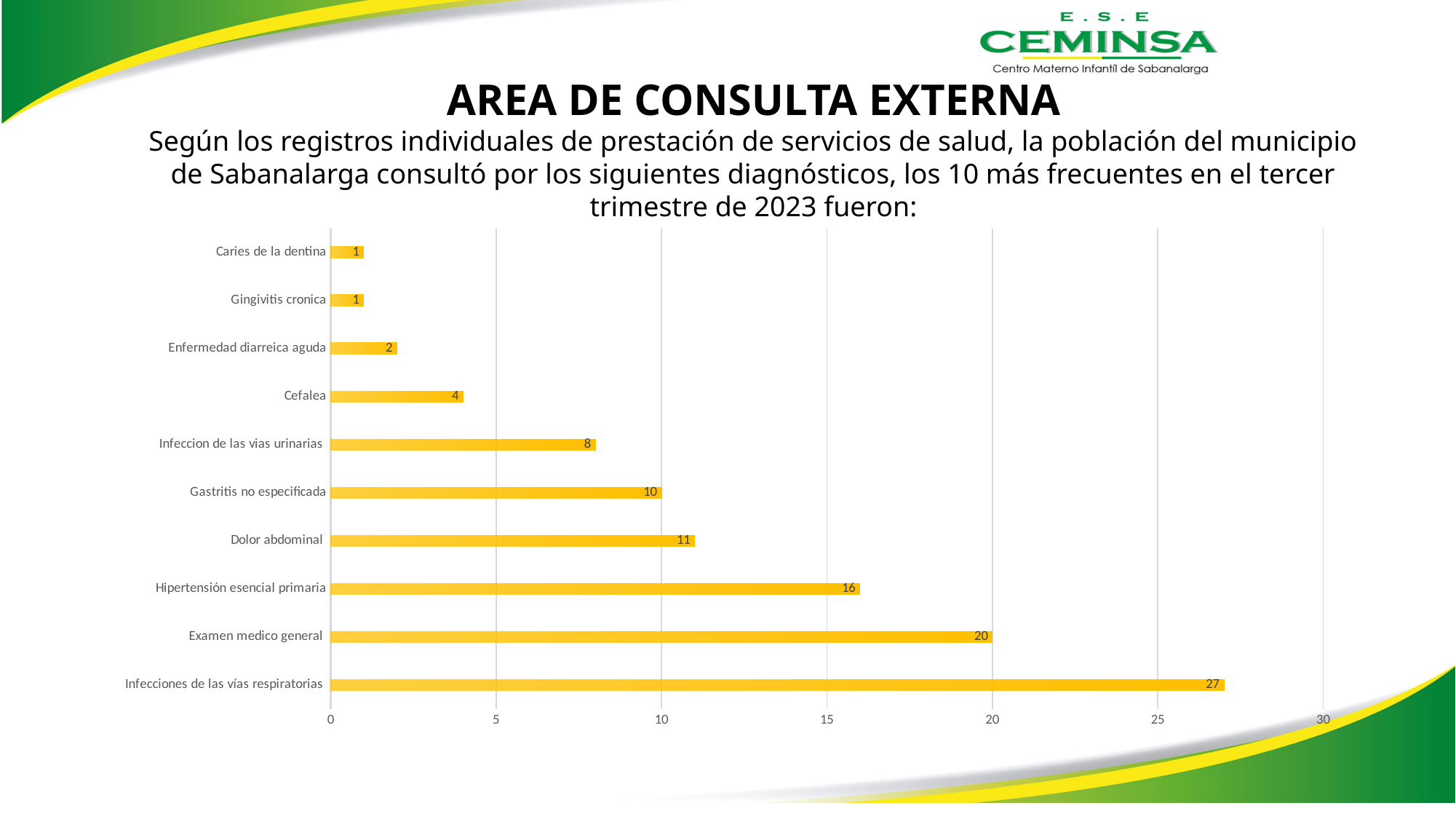
What is the value for Gastritis no especificada? 10 What kind of chart is shown on the slide? bar chart What is the difference between Examen medico general and Dolor abdominal? 9 How many diagnoses are shown in the chart? 10 What is the difference between Infecciones de las vías respiratorias and Examen medico general? 7 Which diagnosis has the highest value? Infecciones de las vías respiratorias What is the value for Hipertensión esencial primaria? 16 Which diagnosis has the lowest value, Cefalea or Enfermedad diarreica aguda? Enfermedad diarreica aguda Is the value for Hipertensión esencial primaria greater or less than 15? greater Which is larger, Infeccion de las vias urinarias or Cefalea? Infeccion de las vias urinarias What is the value for Infecciones de las vías respiratorias? 27 What is the maximum value shown on the horizontal axis? 30